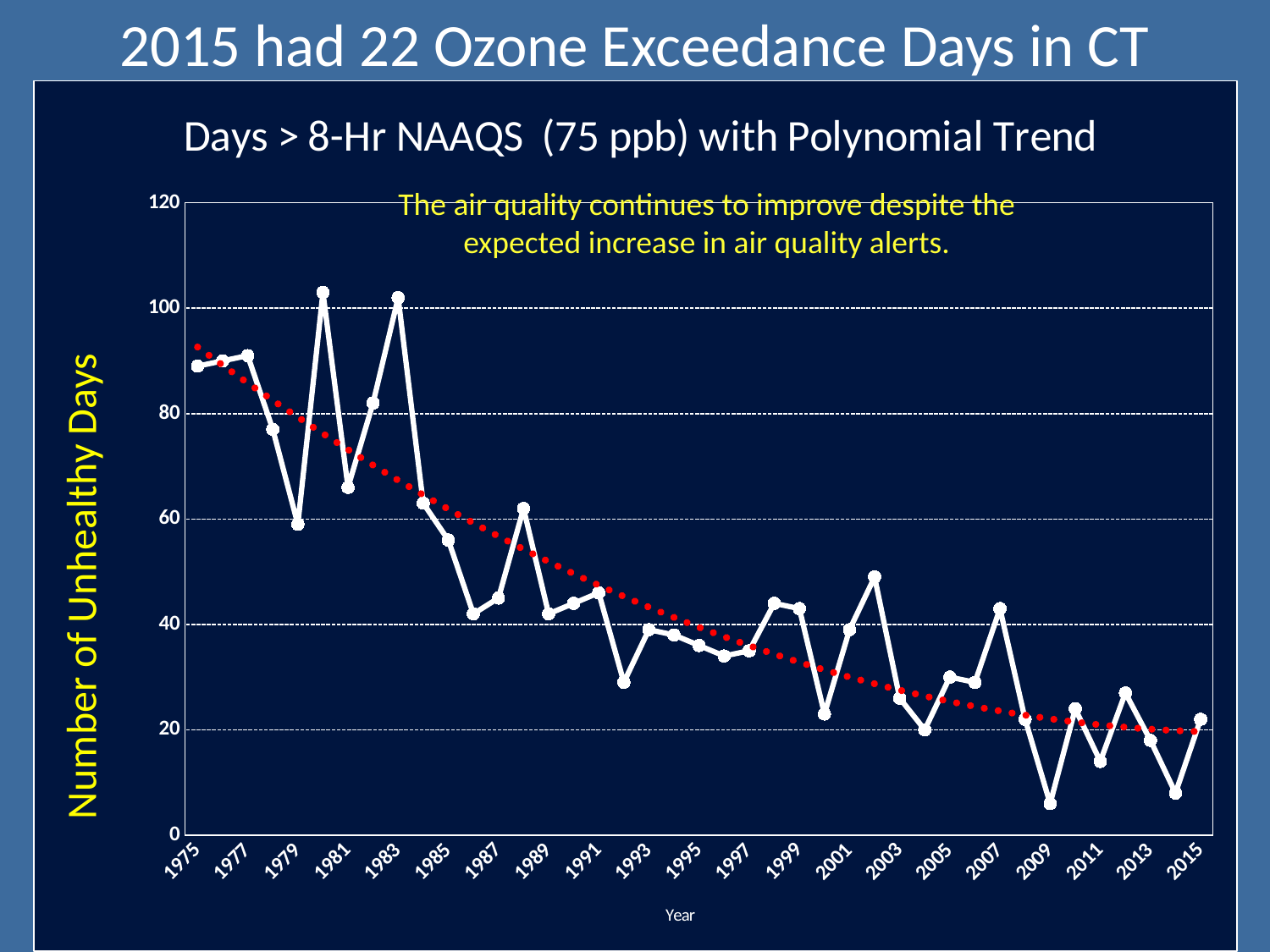
Overall, do the values rise or fall from 1975 to 2015? fall What type of chart is shown on the slide? line chart According to the slide, how many ozone exceedance days did Connecticut have in 2015? 22 Is the value for 1992 greater or less than 40? less Is the value for 1980 greater or less than 100? greater Is the value for 2002 greater or less than 40? greater Which year has the larger value, 1980 or 1985? 1980 What is the title of the y-axis? Number of Unhealthy Days Which year has the larger value, 1975 or 2015? 1975 What is the title of the chart? Days > 8-Hr NAAQS (75 ppb) with Polynomial Trend